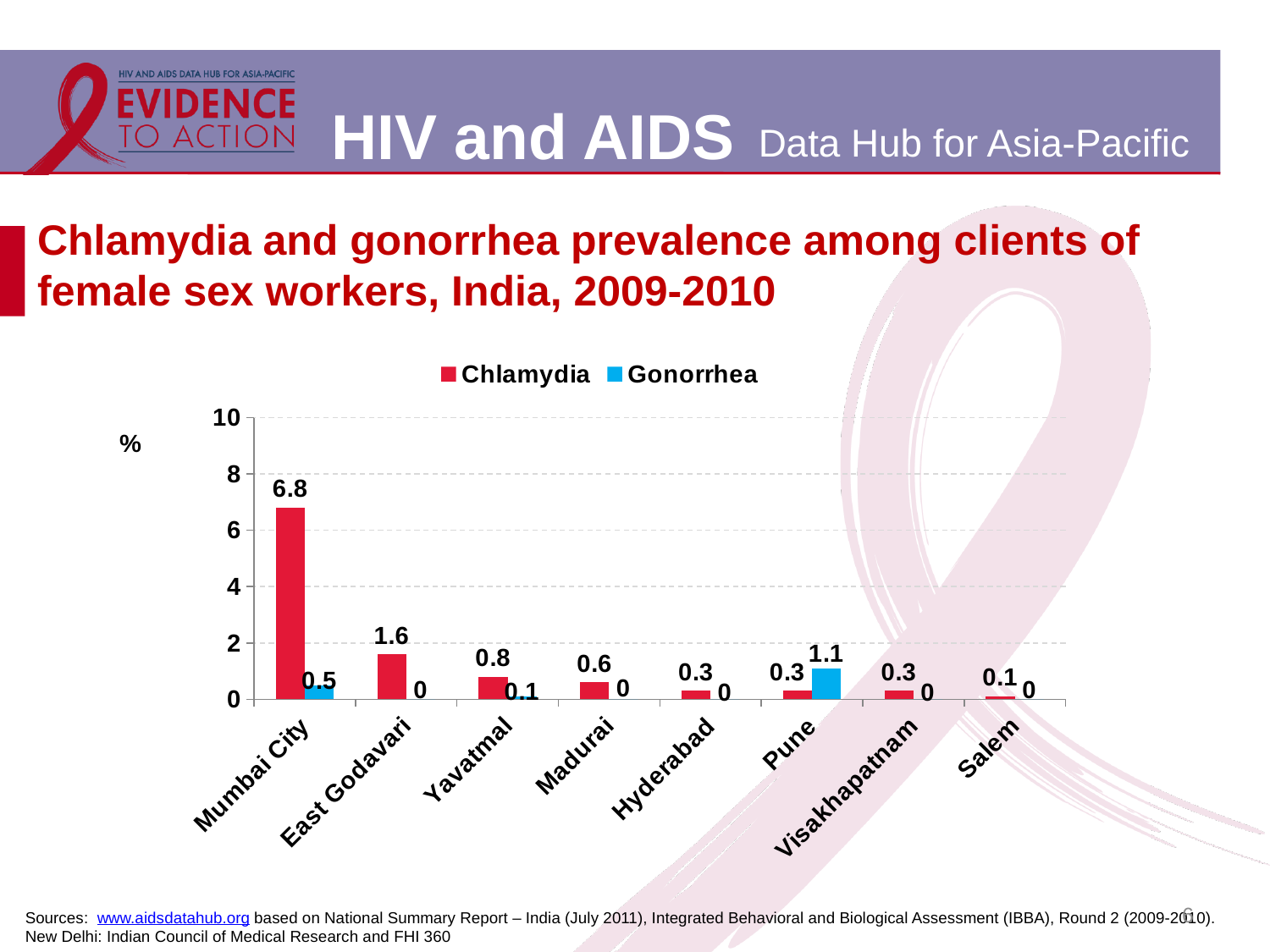
What is the Chlamydia prevalence for East Godavari? 1.6 Which city has the highest Chlamydia prevalence? Mumbai City What is the Gonorrhea prevalence for Pune? 1.1 What type of chart is shown on the slide? Bar chart Which city has the lowest Chlamydia prevalence? Salem Which is larger in Pune: the Chlamydia prevalence or the Gonorrhea prevalence? Gonorrhea How many series does the legend list? 2 How many cities are shown on the x axis? 8 What is the difference between the Chlamydia prevalence in Mumbai City and East Godavari? 5.2 What is the Chlamydia prevalence for Mumbai City? 6.8 What is the Gonorrhea prevalence for Yavatmal? 0.1 Which city has the highest Gonorrhea prevalence? Pune